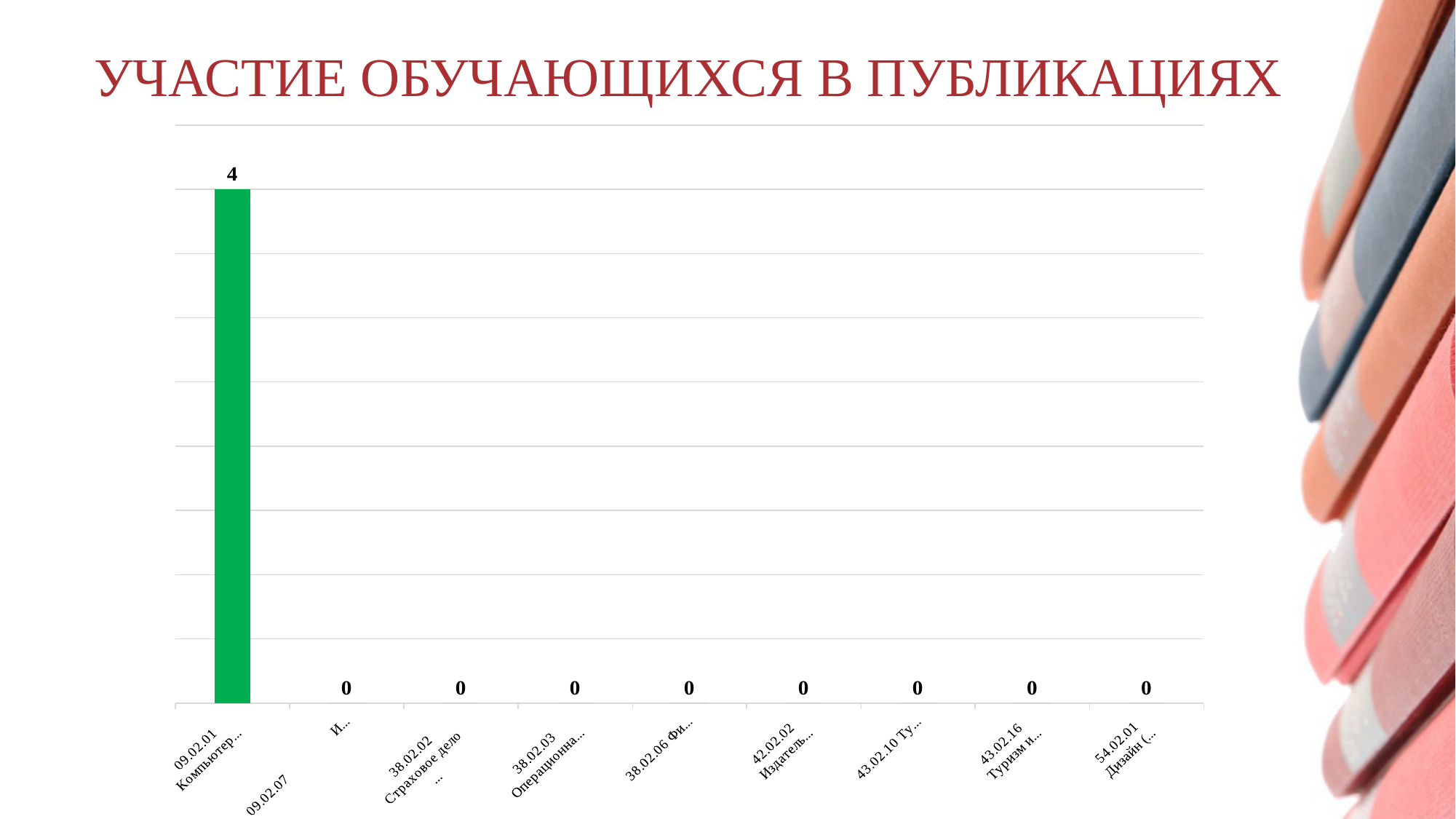
What is the total of all the values shown in the chart? 4 What is the value for the category 54.02.01? 0 What is the difference between the values for 09.02.01 and 43.02.16? 4 What kind of chart is shown on the slide? bar chart How many categories are shown on the x axis? 9 What is the title of the slide? УЧАСТИЕ ОБУЧАЮЩИХСЯ В ПУБЛИКАЦИЯХ Which is larger, the value for 09.02.01 or the value for 42.02.02? 09.02.01 Which category has the highest value? 09.02.01 What is the value for the category 38.02.02? 0 What is the value for the category 09.02.01? 4 What colour is the bar for 09.02.01? green How many categories have a value of 0? 8